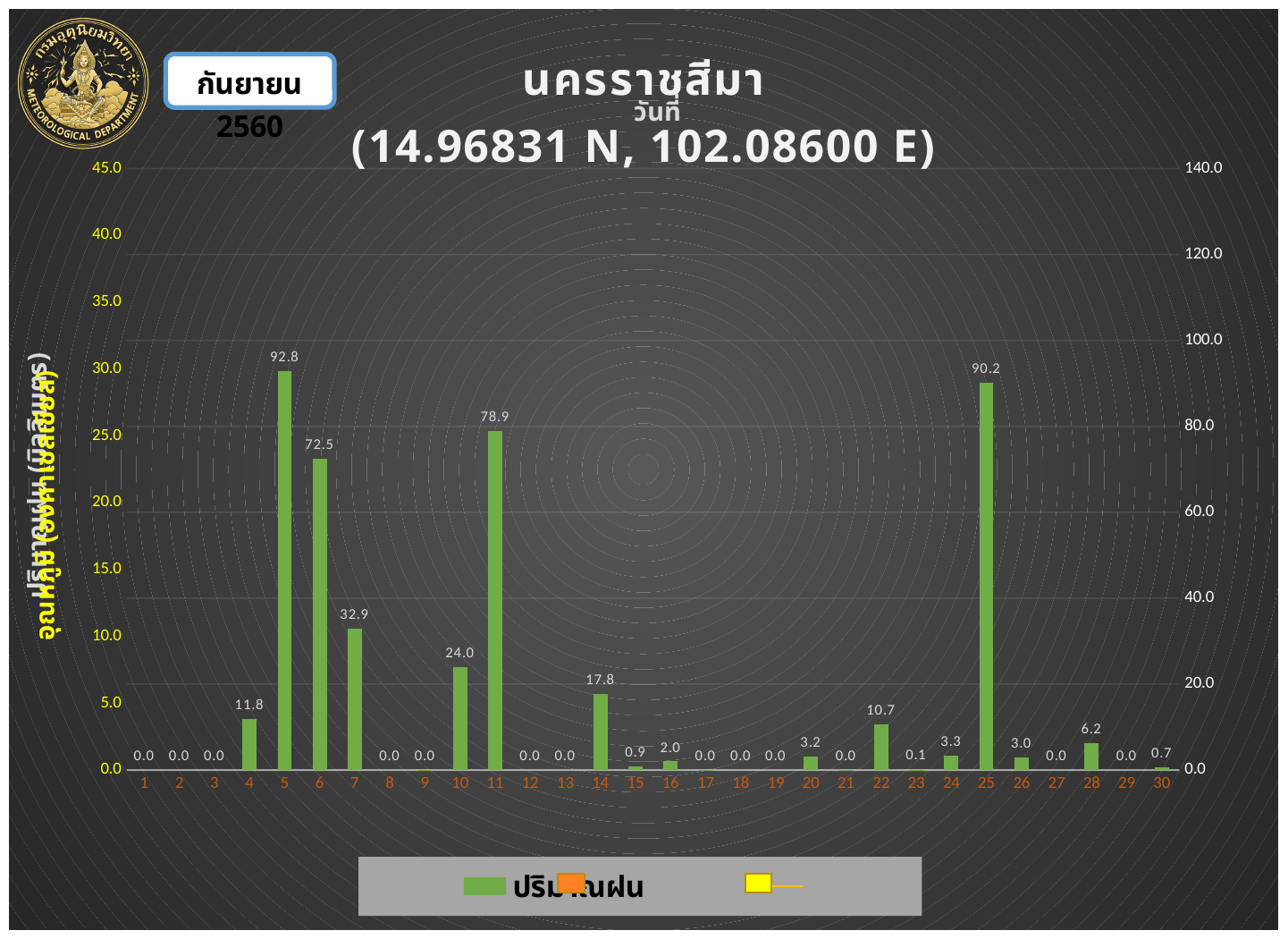
Which has a larger rainfall value, day 10 or day 14? day 10 Is the value for day 11 greater or less than 60.0 on the right axis? greater What is the difference between the rainfall values for day 5 and day 25? 2.6 What is the rainfall value for day 11? 78.9 What kind of chart is shown on the slide? bar chart Which day has the highest rainfall value? 5 How many days are shown on the x axis of the chart? 30 What is the rainfall value for day 25? 90.2 What is the rainfall value for day 5? 92.8 What is the rainfall value for day 22? 10.7 Which has a larger rainfall value, day 4 or day 28? day 4 What is the difference between the rainfall values for day 6 and day 7? 39.6